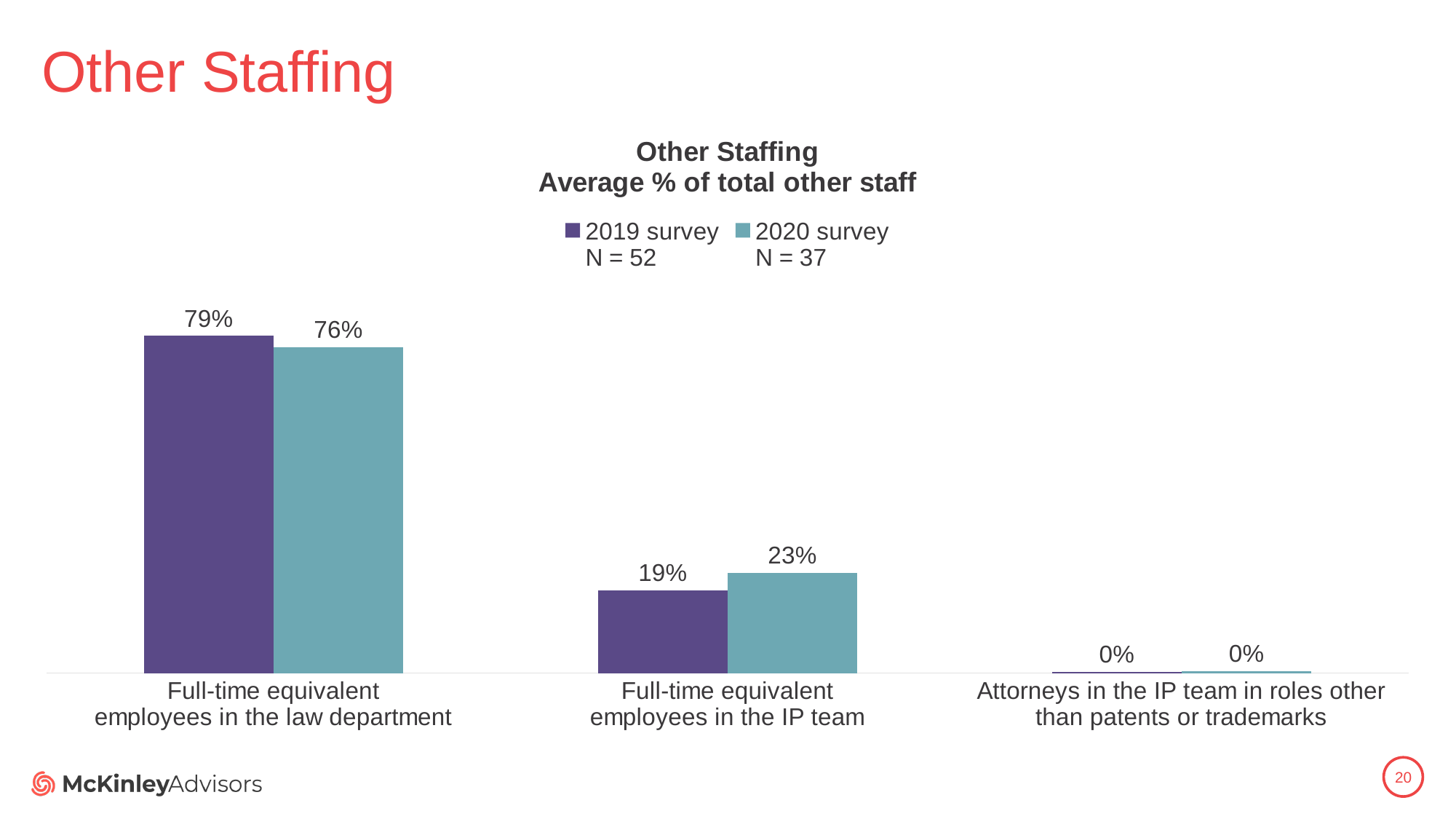
Which category has the highest value in the 2019 survey? Full-time equivalent employees in the law department Which category has the lowest value in the 2020 survey? Attorneys in the IP team in roles other than patents or trademarks What is the 2020 survey value for full-time equivalent employees in the law department? 76% What is the difference between the 2019 and 2020 survey values for full-time equivalent employees in the law department? 3 percentage points What is the 2019 survey value for full-time equivalent employees in the law department? 79% What kind of chart is shown on the slide? Bar chart How many categories are shown on the x axis? 3 What is the 2019 survey value for attorneys in the IP team in roles other than patents or trademarks? 0% For full-time equivalent employees in the IP team, which survey shows the larger value, 2019 or 2020? 2020 survey What is the 2020 survey value for full-time equivalent employees in the IP team? 23% What is the sample size (N) for the 2020 survey shown in the legend? N = 37 How many series does the legend list? 2